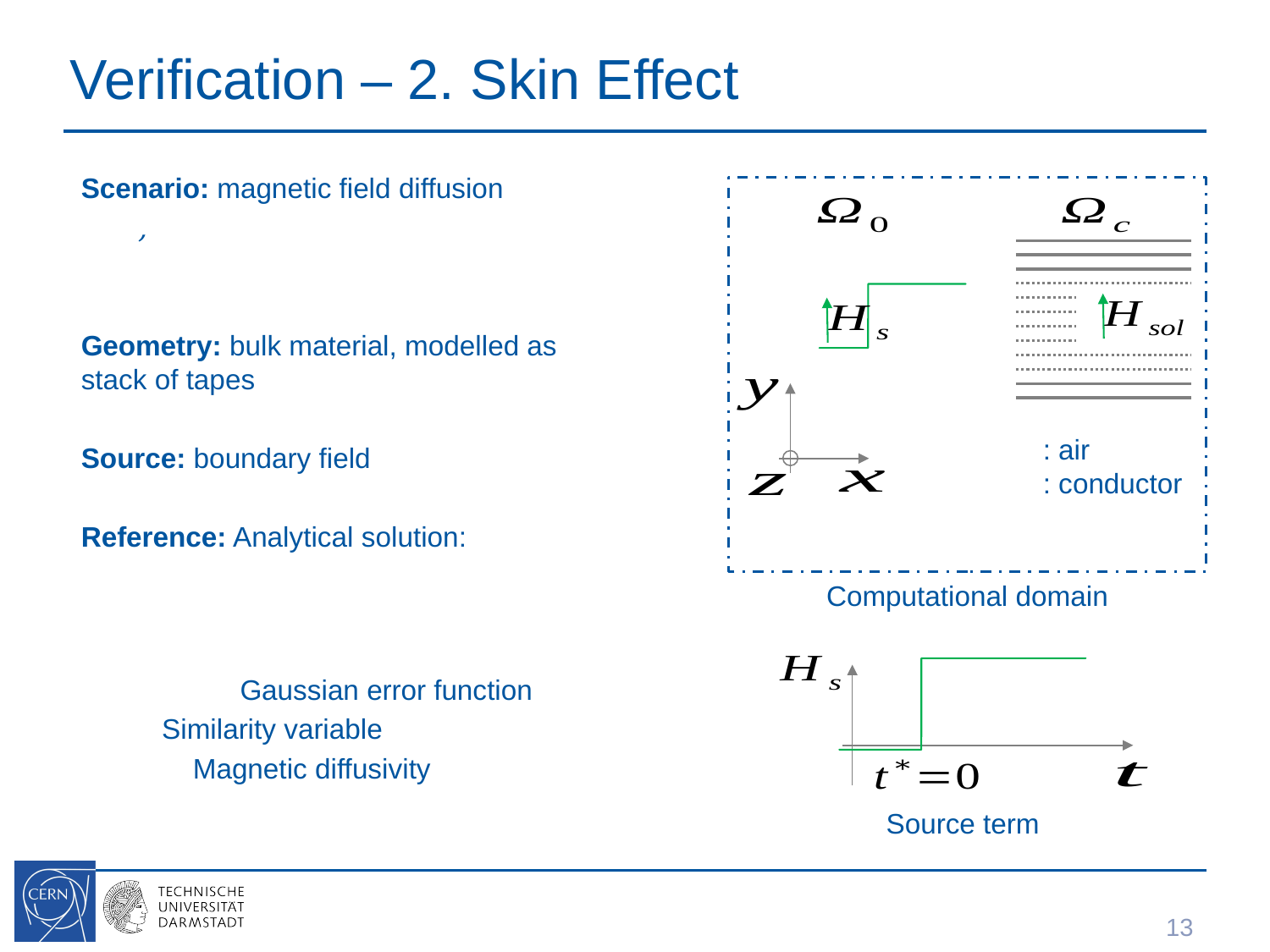
In the 'Source term' plot at the bottom right, at what labelled time does the step in H_s occur? t* = 0 In the 'Source term' plot at the bottom right, what quantity is labelled on the vertical axis? H_s In the 'Source term' plot at the bottom right, what quantity is labelled on the horizontal axis? t In the 'Source term' plot at the bottom right, does the plotted H_s curve rise or fall as t increases past t* = 0? rises